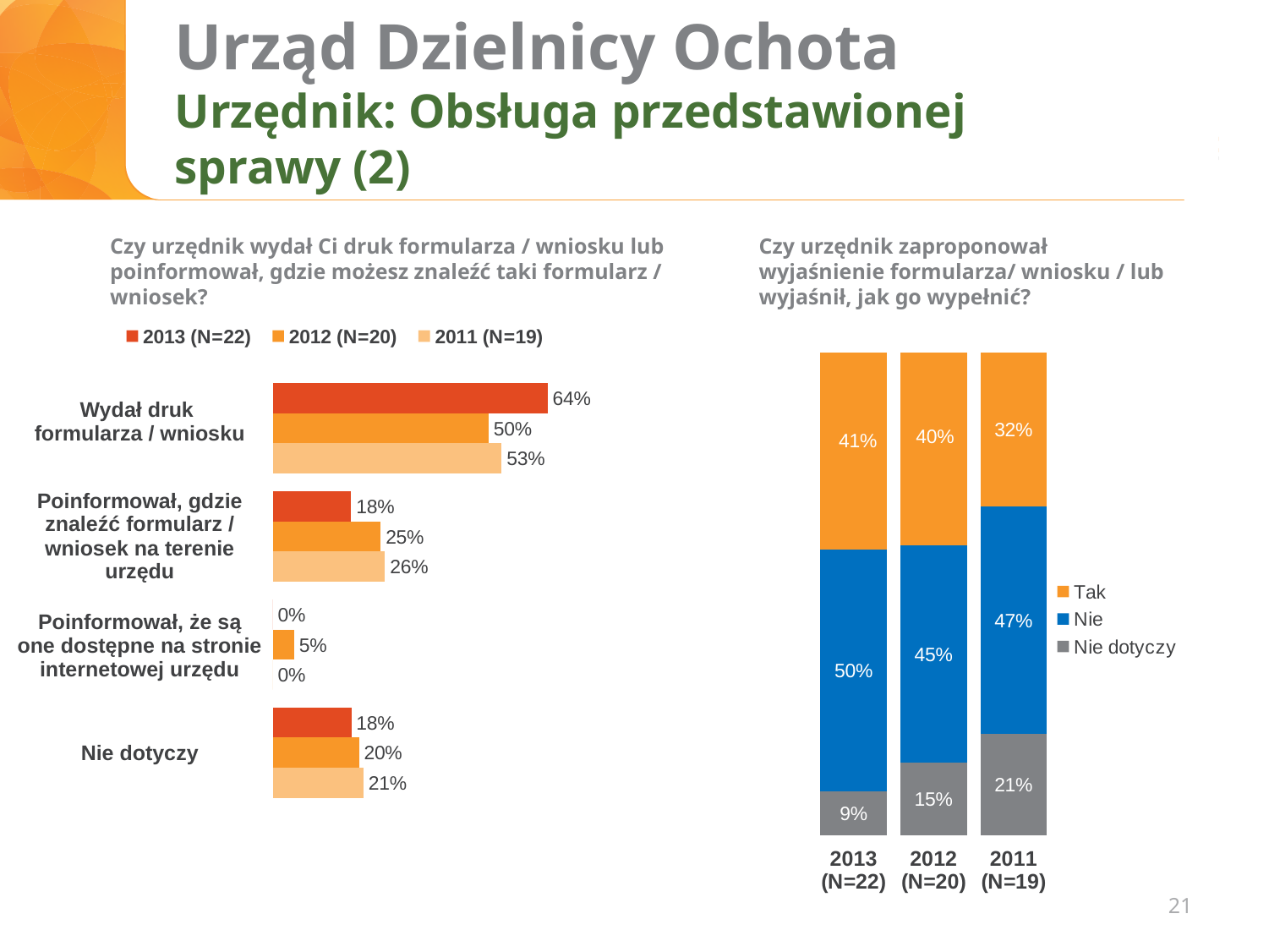
In the right chart, what is the total of the stacked bar for 2013 (N=22)? 100% What kind of chart is the chart on the right? Stacked bar chart In the left chart, which category has the highest value for 2013 (N=22)? Wydał druk formularza / wniosku In the left chart, what is the difference between the 2013 and 2012 values for 'Wydał druk formularza / wniosku'? 14 percentage points In the left chart, what is the 2012 (N=20) value for 'Poinformował, że są one dostępne na stronie internetowej urzędu'? 5% In the left chart, what is the value for 'Wydał druk formularza / wniosku' in 2013 (N=22)? 64% In the right chart, what is the 'Nie' share for 2012 (N=20)? 45% In the left chart, how many categories are shown? 4 In the right chart, which year has the highest 'Nie dotyczy' share? 2011 (N=19) In the left chart, how many series does the legend list? 3 In the left chart, what is the 2011 (N=19) value for 'Poinformował, gdzie znaleźć formularz / wniosek na terenie urzędu'? 26% In the right chart, is the 'Tak' share for 2013 (N=22) larger or smaller than for 2011 (N=19)? Larger